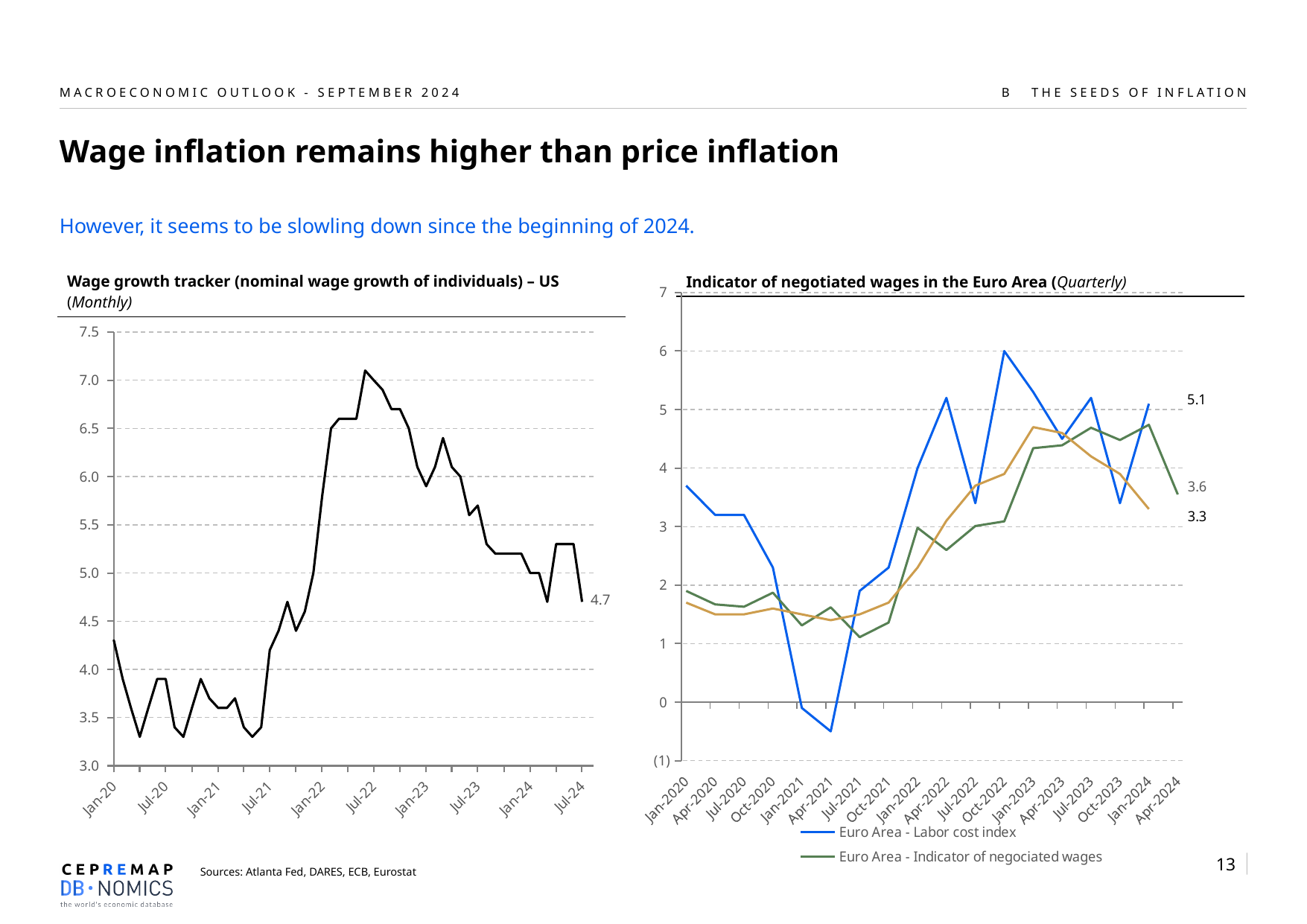
In the right chart (Indicator of negotiated wages in the Euro Area), what is the difference between the labeled end value of the Labor cost index (5.1) and the labeled end value of the Indicator of negociated wages (3.6)? 1.5 In the left chart (Wage growth tracker – US), is the value at Jan-20 greater or less than 4.0? greater In the left chart (Wage growth tracker – US), what is the labeled value at the end of the series (Jul-24)? 4.7 In the left chart (Wage growth tracker – US), is the value at Jul-24 greater or less than 5.0? less How many series does the legend of the right chart (Indicator of negotiated wages in the Euro Area) list? 2 In the right chart (Indicator of negotiated wages in the Euro Area), what is the labeled value of the Euro Area - Indicator of negociated wages at Apr-2024? 3.6 In the right chart (Indicator of negotiated wages in the Euro Area), does the Euro Area - Indicator of negociated wages rise or fall overall between Jan-2020 and Jan-2024? Rise In the right chart (Indicator of negotiated wages in the Euro Area), which series reaches the highest value on the chart? Euro Area - Labor cost index What kind of chart is the left chart, 'Wage growth tracker (nominal wage growth of individuals) – US'? Line chart In the right chart (Indicator of negotiated wages in the Euro Area), what is the labeled value of the Euro Area - Labor cost index at Jan-2024? 5.1 In the right chart (Indicator of negotiated wages in the Euro Area), is the Euro Area - Labor cost index at Apr-2021 greater or less than 0? less In the left chart (Wage growth tracker – US), does the series rise or fall between Jul-22 and Jul-24? Fall